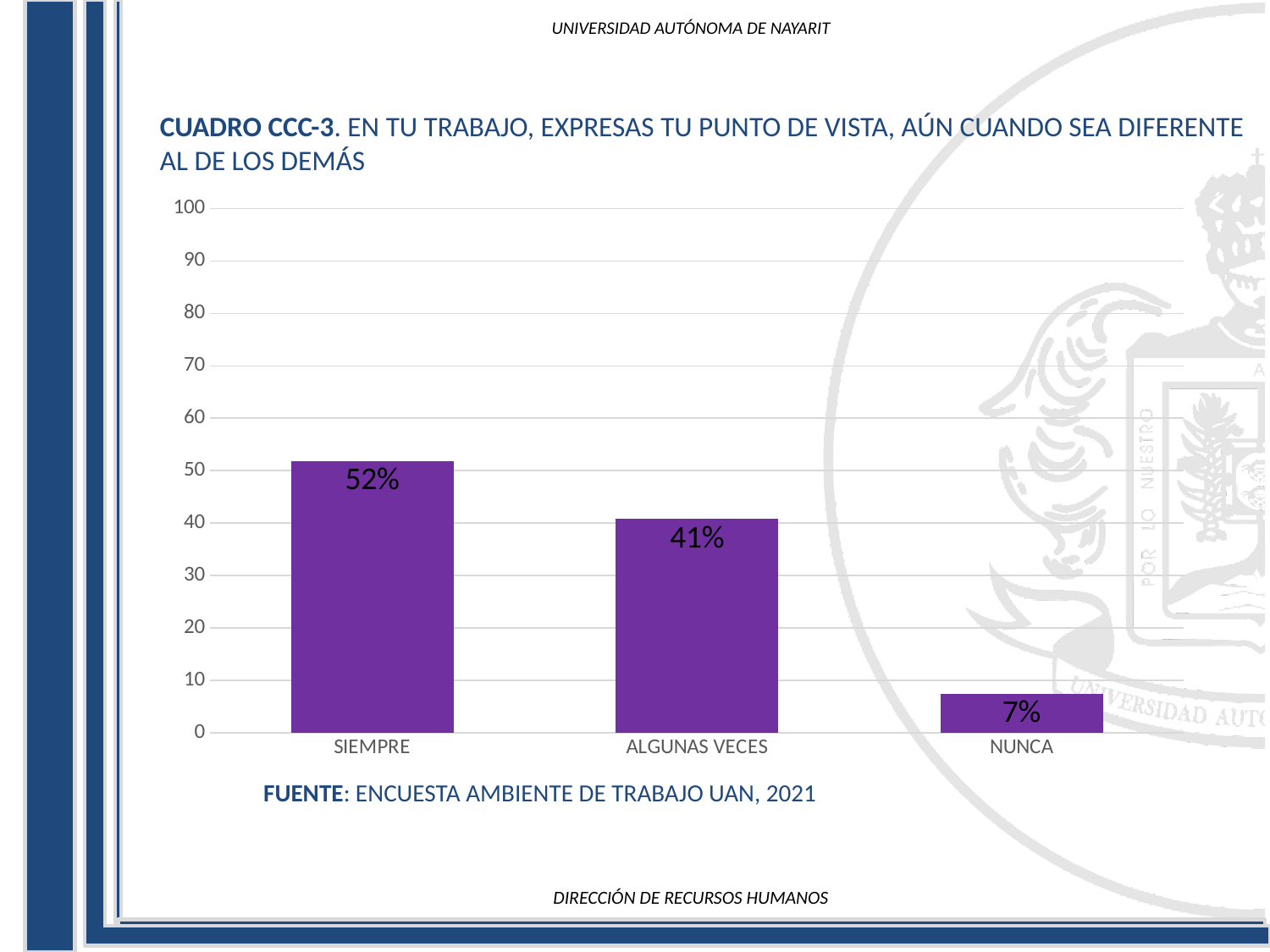
Which category has the highest value? SIEMPRE What kind of chart is shown on the slide? bar chart Which is larger, the value for ALGUNAS VECES or the value for NUNCA? ALGUNAS VECES What is the value for ALGUNAS VECES? 41% What is the value for SIEMPRE? 52% What is the difference between the values for ALGUNAS VECES and NUNCA? 34% How many categories are shown on the x axis? 3 Is the value for SIEMPRE greater or less than 50? greater What is the value for NUNCA? 7% What is the difference between the values for SIEMPRE and ALGUNAS VECES? 11% What source is cited below the chart? ENCUESTA AMBIENTE DE TRABAJO UAN, 2021 Which category has the lowest value? NUNCA